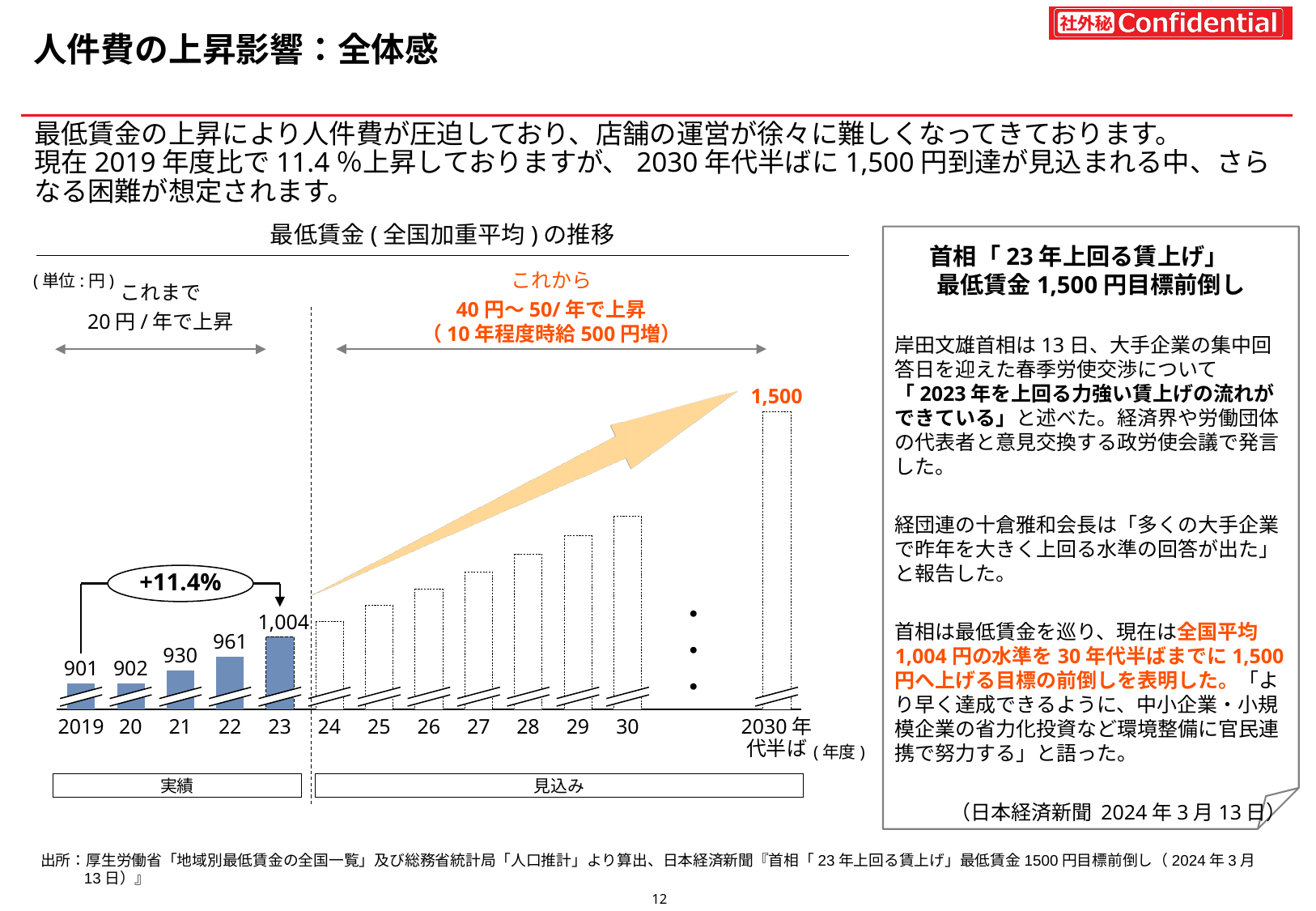
Which is larger, the value for 2021 or the value for 2022? 2022 Which year has the lowest labelled value in the chart? 2019 What is the minimum wage value shown for 2023 (23)? 1,004 What is the difference between the 2023 value (1,004) and the 2019 value (901)? 103 Which category has the highest labelled value in the chart? 2030年代半ば What is the minimum wage value shown for 2019? 901 How many years are shown in the 実績 (actual) section of the chart? 5 What is the value shown for 2022 (22)? 961 What is the title of the chart? 最低賃金(全国加重平均)の推移 Do the values rise or fall from 2019 to 2030年代半ば? rise What value is shown for 2030年代半ば? 1,500 What is the difference between the 2030年代半ば target (1,500) and the 2023 value (1,004)? 496